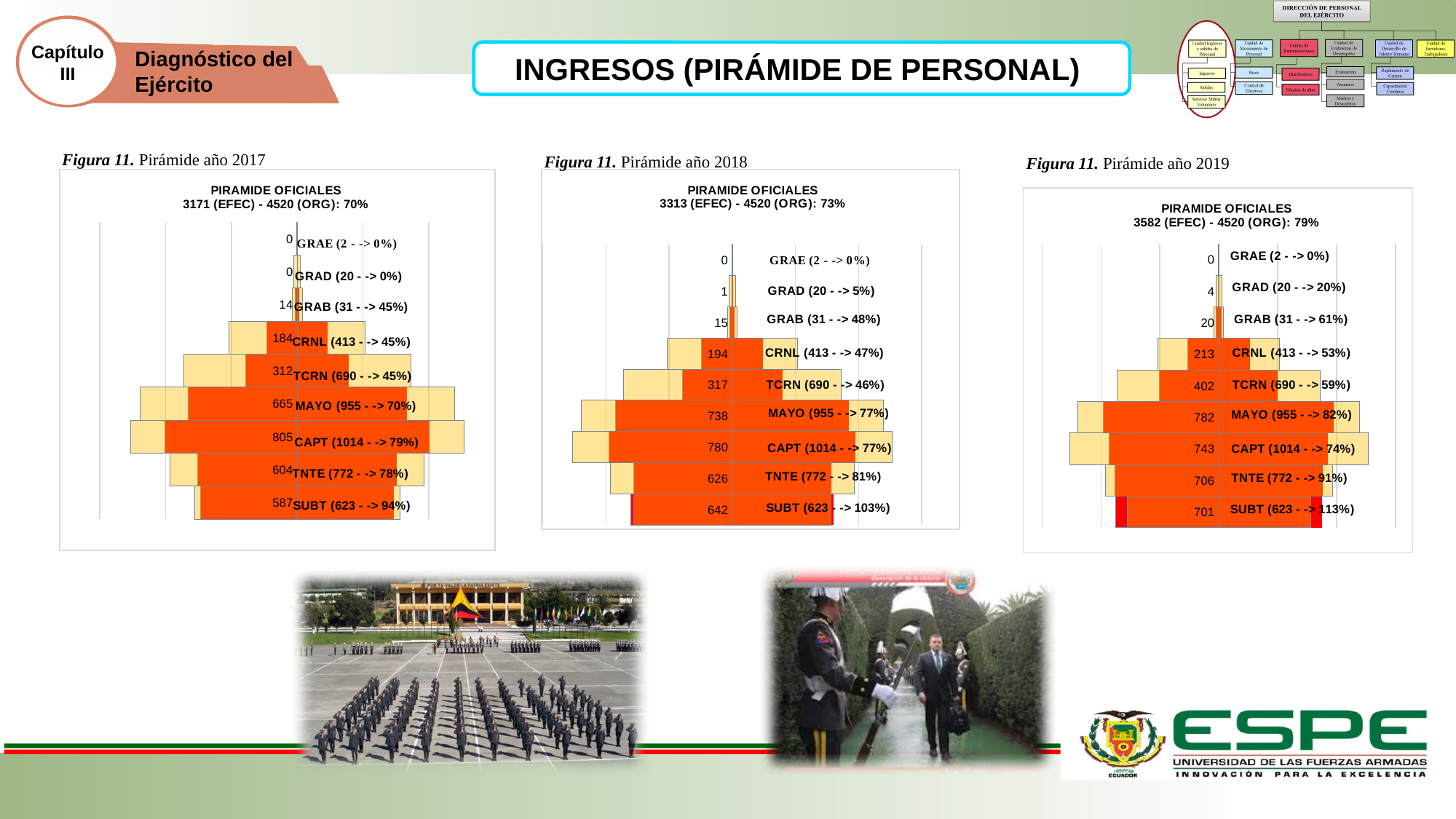
In the Pirámide año 2017 chart, which is larger, the value for TNTE or the value for SUBT? TNTE What percentage is shown in the title of the Pirámide año 2019 chart? 79% In the Pirámide año 2017 chart, which rank has the lowest value, GRAB or CRNL? GRAB In the Pirámide año 2018 chart, which rank has the highest value? CAPT In the Pirámide año 2018 chart, what is the value for MAYO? 738 In the Pirámide año 2019 chart, which rank has the highest value? MAYO In the Pirámide año 2019 chart, what is the difference between the values for MAYO and CAPT? 39 How many rank categories are shown in the Pirámide año 2018 chart? 9 In the Pirámide año 2019 chart, what is the value for TCRN? 402 In the Pirámide año 2018 chart, what is the difference between the values for SUBT and TNTE? 16 What kind of chart is the Pirámide año 2017 chart? Bar chart In the Pirámide año 2017 chart, what is the value for CAPT? 805